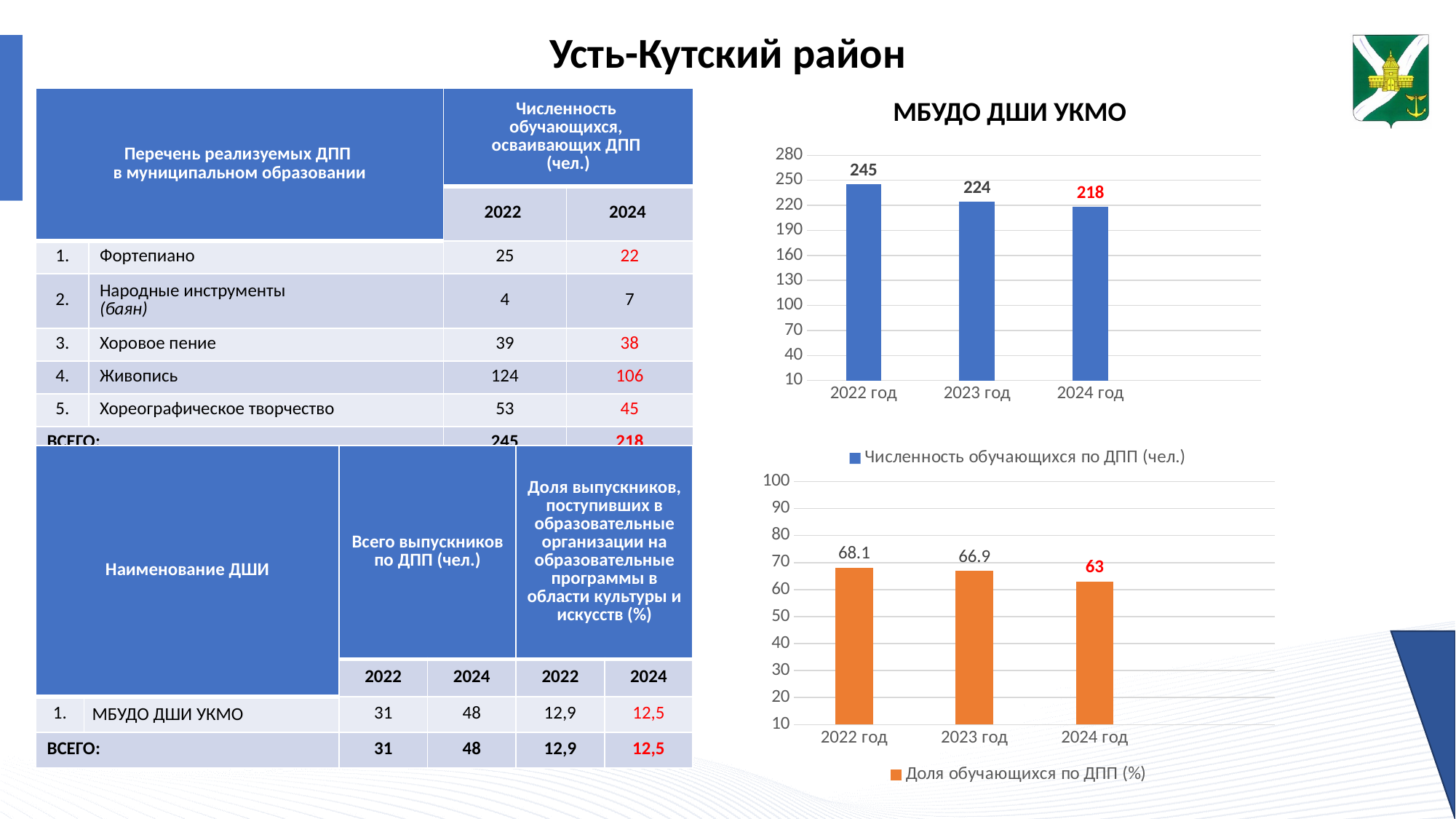
In the top chart (МБУДО ДШИ УКМО), do the values rise or fall from 2022 год to 2024 год? fall In the top chart (МБУДО ДШИ УКМО), what is the value for 2024 год? 218 In the bottom chart, which year has the lowest value? 2024 год In the top chart (МБУДО ДШИ УКМО), what kind of chart is shown? bar chart In the bottom chart, how many bars are plotted? 3 In the top chart (МБУДО ДШИ УКМО), which year has the highest value? 2022 год In the bottom chart, what is the legend entry for the series? Доля обучающихся по ДПП (%) In the top chart (МБУДО ДШИ УКМО), what is the value for 2022 год? 245 In the bottom chart, what is the value for 2024 год? 63 In the bottom chart, what is the value for 2023 год? 66.9 In the bottom chart, is the value for 2022 год larger or smaller than the value for 2023 год? larger In the top chart (МБУДО ДШИ УКМО), what is the difference between the values for 2022 год and 2024 год? 27